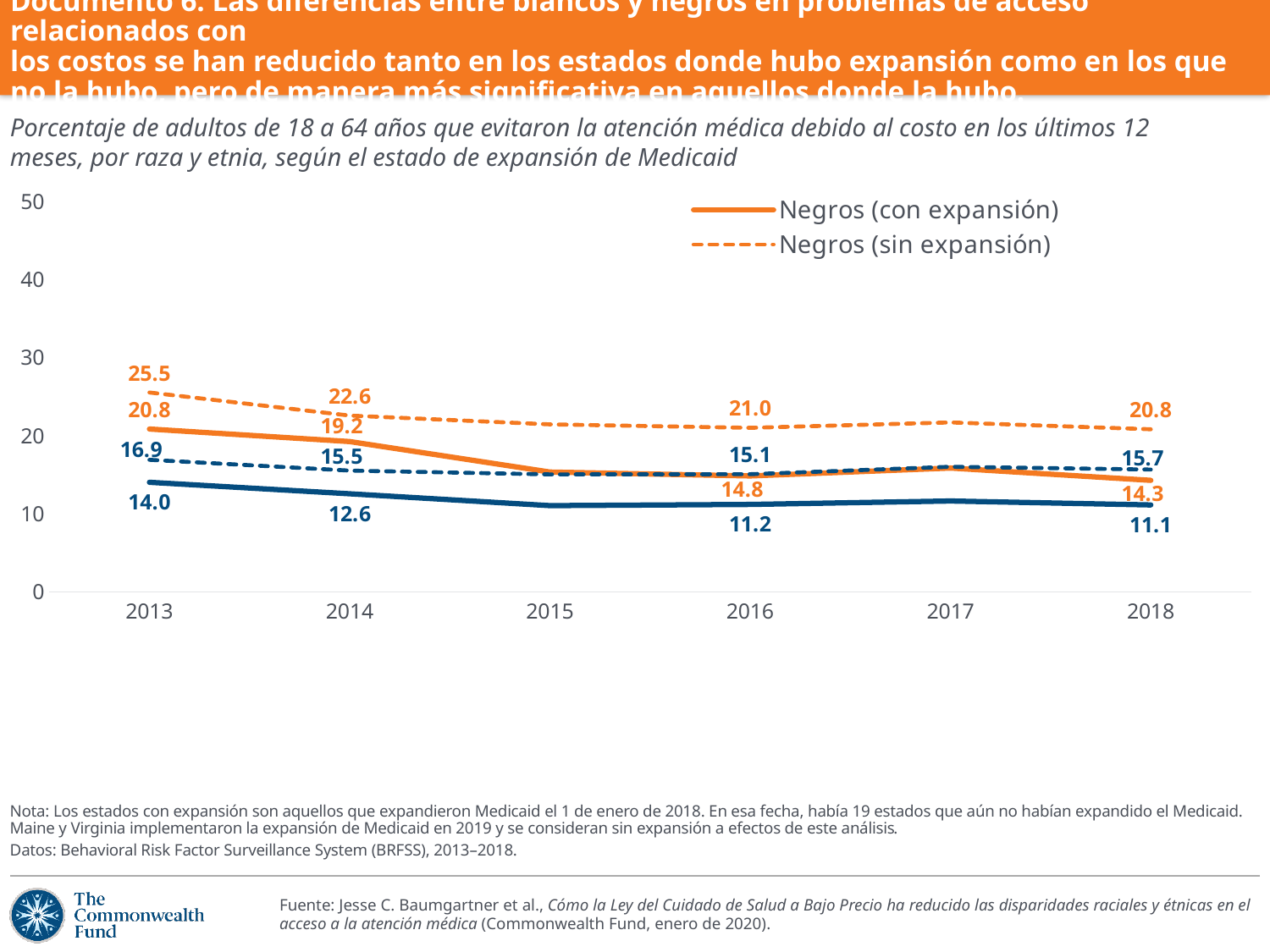
How many series does the legend list? 2 What is the difference between Negros (sin expansión) and Negros (con expansión) in 2018? 6.5 What value is shown for Negros (con expansión) in 2018? 14.3 By how much did the Negros (con expansión) value fall from 2013 to 2018? 6.5 What value is shown for Negros (sin expansión) in 2013? 25.5 Which is larger in 2016: Negros (con expansión) or Negros (sin expansión)? Negros (sin expansión) What value is shown for Negros (con expansión) in 2014? 19.2 How many years are shown on the x axis? 6 Is the value for Negros (sin expansión) in 2015 greater or less than 20? greater In which year is the Negros (con expansión) series highest? 2013 What value is shown for Negros (sin expansión) in 2016? 21.0 Does the Negros (con expansión) series generally rise or fall from 2013 to 2018? fall